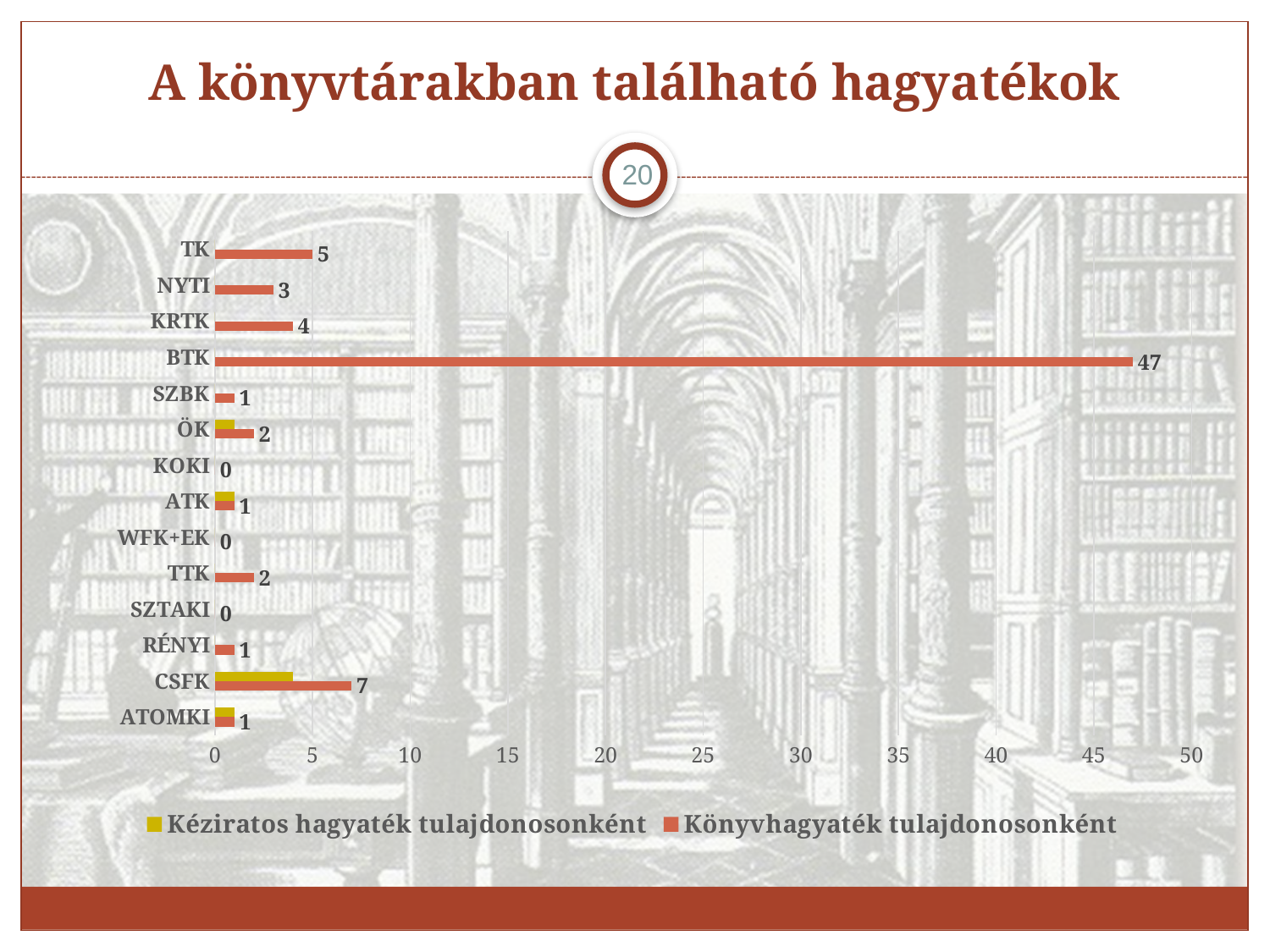
What is the value of Könyvhagyaték tulajdonosonként for CSFK? 7 How many series does the legend list? 2 Which has a larger Könyvhagyaték tulajdonosonként value, TK or NYTI? TK Which category has the highest value for Könyvhagyaték tulajdonosonként? BTK Is the Könyvhagyaték tulajdonosonként value for BTK greater or less than 45? greater What is the value of Könyvhagyaték tulajdonosonként for TK? 5 What is the value of Könyvhagyaték tulajdonosonként for BTK? 47 What kind of chart is shown on the slide? bar chart What is the value of Könyvhagyaték tulajdonosonként for KRTK? 4 Which series is shown in yellow in the legend? Kéziratos hagyaték tulajdonosonként What is the difference between the Könyvhagyaték tulajdonosonként values for BTK and CSFK? 40 How many categories are shown on the chart? 14